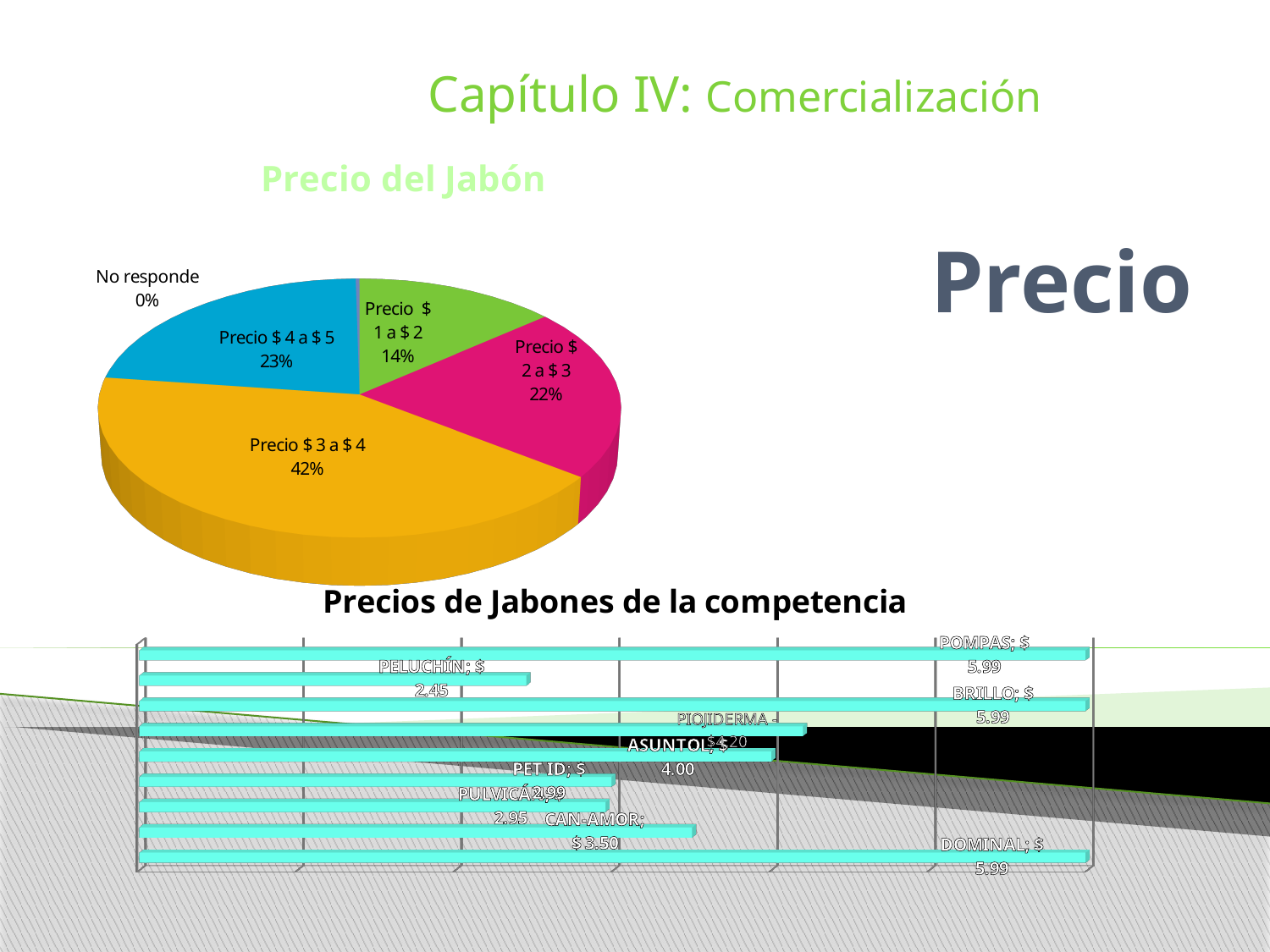
In the chart 'Precios de Jabones de la competencia', what is the price shown for PELUCHÍN? $ 2.45 In the pie chart 'Precio del Jabón', what share is shown for 'Precio $ 1 a $ 2'? 14% In the pie chart 'Precio del Jabón', which category has the smallest share? No responde In the pie chart 'Precio del Jabón', what share is shown for 'Precio $ 3 a $ 4'? 42% How many categories are shown in the pie chart 'Precio del Jabón'? 5 In the chart 'Precios de Jabones de la competencia', how many brands are listed? 9 In the chart 'Precios de Jabones de la competencia', which is larger: the price for PIOJIDERMA or the price for PET ID? PIOJIDERMA In the pie chart 'Precio del Jabón', what is the difference in percentage points between 'Precio $ 3 a $ 4' and 'Precio $ 2 a $ 3'? 20 In the pie chart 'Precio del Jabón', which is larger: 'Precio $ 4 a $ 5' or 'Precio $ 1 a $ 2'? Precio $ 4 a $ 5 In the pie chart 'Precio del Jabón', which price range has the largest share? Precio $ 3 a $ 4 What kind of chart is 'Precios de Jabones de la competencia'? Bar chart In the chart 'Precios de Jabones de la competencia', what is the price shown for CAN-AMOR? $ 3.50